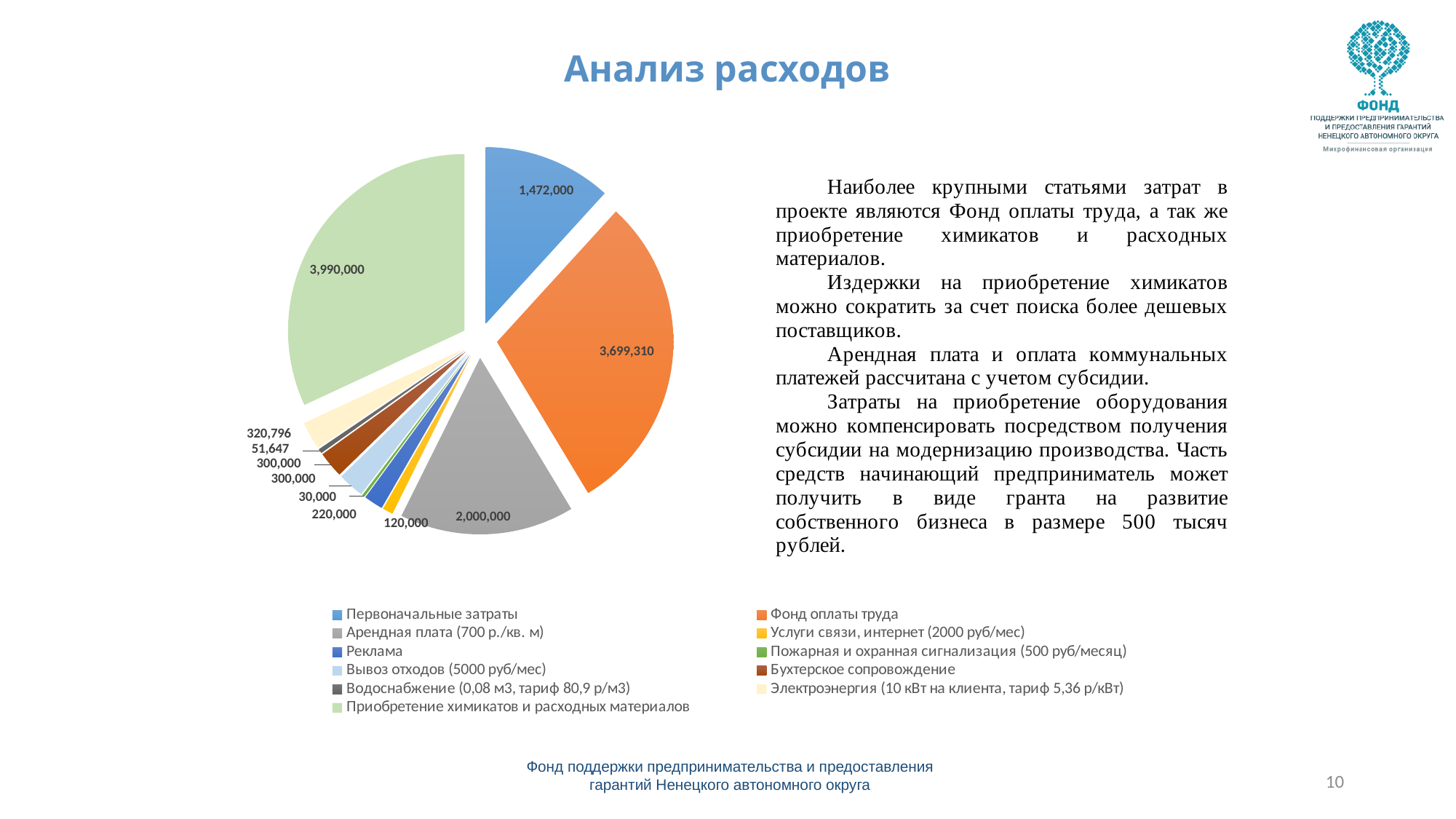
What is the title of the slide containing the pie chart? Анализ расходов What is the difference between the values for Приобретение химикатов и расходных материалов and Фонд оплаты труда? 290,690 Which is larger: Арендная плата (700 р./кв. м) or Первоначальные затраты? Арендная плата (700 р./кв. м) What is the value for Водоснабжение (0,08 м3, тариф 80,9 р/м3)? 51,647 What is the value for Приобретение химикатов и расходных материалов? 3,990,000 Which category has the smallest slice of the pie? Пожарная и охранная сигнализация (500 руб/месяц) What kind of chart is shown on the slide? Pie chart What is the value for Фонд оплаты труда? 3,699,310 What is the value for Арендная плата (700 р./кв. м)? 2,000,000 What is the value for Первоначальные затраты? 1,472,000 Which category has the largest slice of the pie? Приобретение химикатов и расходных материалов How many categories does the legend of the pie chart list? 11